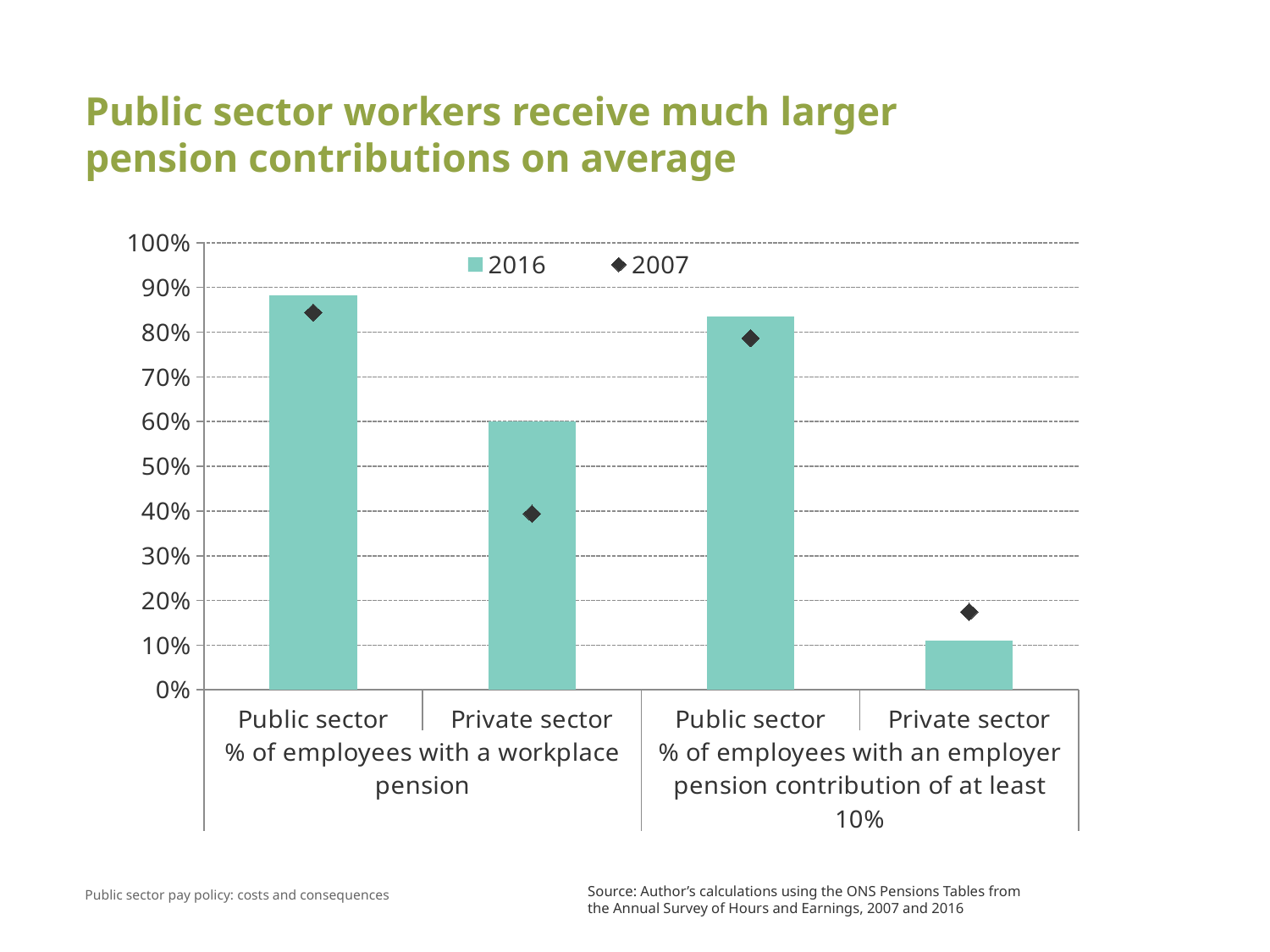
Is the 2016 value for Private sector, % of employees with a workplace pension, greater or less than 50%? greater What kind of chart is shown on the slide? combination bar and line chart (bars for 2016 with diamond markers for 2007) What is the title of the slide? Public sector workers receive much larger pension contributions on average How many categories (bars) are plotted on the chart? 4 For Private sector, % of employees with a workplace pension, which is larger: the 2016 value or the 2007 value? 2016 How many series does the legend list? 2 Is the 2016 value for Private sector, % of employees with an employer pension contribution of at least 10%, greater or less than 20%? less Is the 2007 value for Private sector, % of employees with a workplace pension, greater or less than 50%? less Which category has the lowest 2016 bar? Private sector (% of employees with an employer pension contribution of at least 10%) Which category has the highest 2016 bar? Public sector (% of employees with a workplace pension) For Private sector, % of employees with an employer pension contribution of at least 10%, which is larger: the 2016 value or the 2007 value? 2007